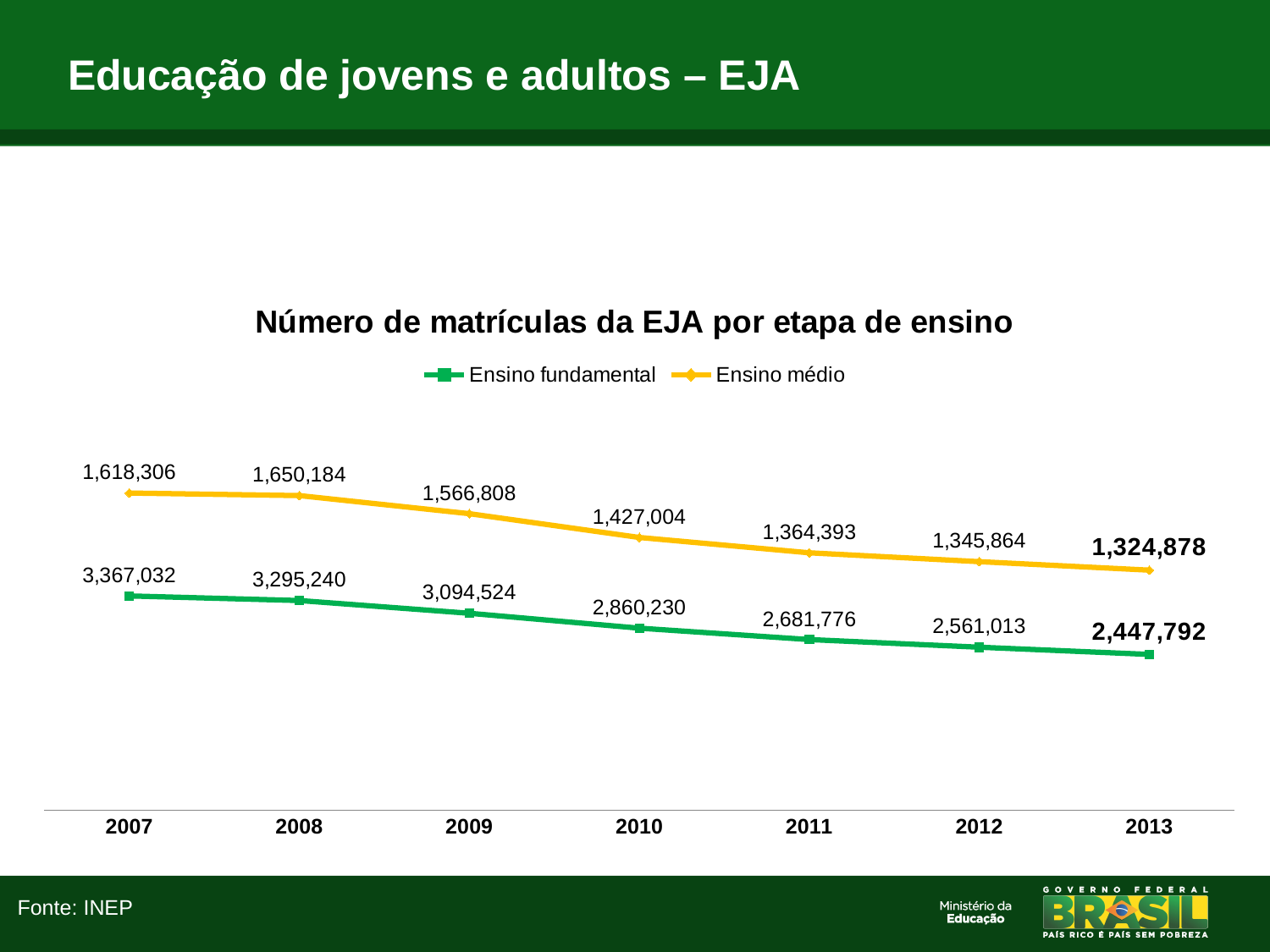
What is the value for Ensino fundamental in 2007? 3,367,032 In which year is the Ensino fundamental value lowest? 2013 Which series has the larger value in 2009, Ensino fundamental or Ensino médio? Ensino fundamental What is the value for Ensino médio in 2013? 1,324,878 What is the difference between the Ensino fundamental values in 2007 and 2013? 919,240 How many series does the legend list? 2 In which year is the Ensino médio value highest? 2008 What is the value for Ensino médio in 2010? 1,427,004 What is the value for Ensino fundamental in 2011? 2,681,776 What is the difference between Ensino fundamental and Ensino médio in 2013? 1,122,914 How many years are shown on the x axis? 7 What kind of chart is shown on the slide? Line chart